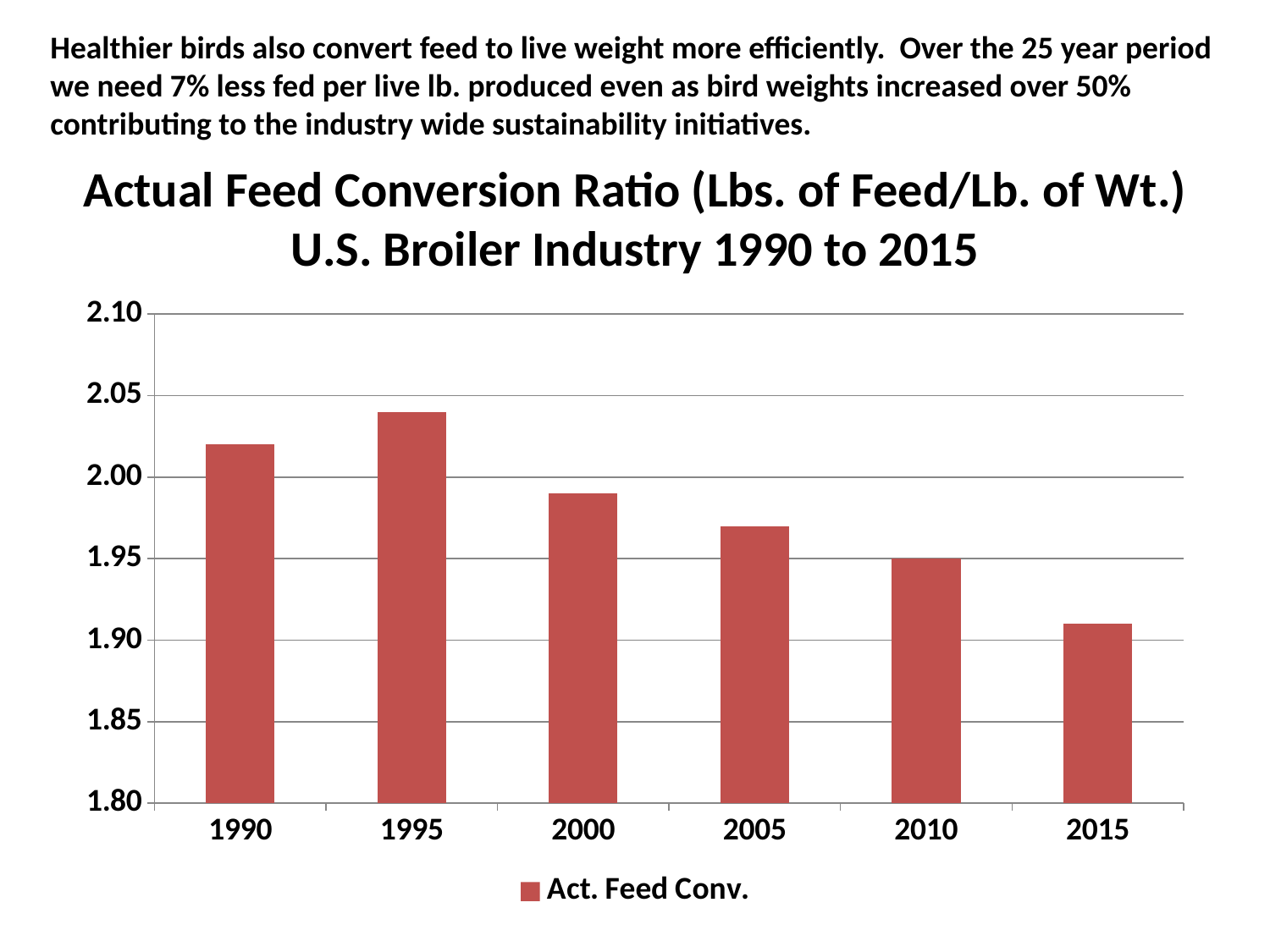
Which year has the lowest actual feed conversion ratio? 2015 Is the value for 1990 greater or less than 2.00? greater Is the value for 2015 greater or less than 1.95? less Is the value for 1995 greater or less than 2.05? less What is the name of the series shown in the legend? Act. Feed Conv. How many series does the legend list? 1 What type of chart is shown on the slide? bar chart How many years are plotted on the x axis of the chart? 6 Which is larger, the value for 1990 or the value for 2005? 1990 From 1995 to 2015, do the values rise or fall along the x axis? fall Which year has the highest actual feed conversion ratio? 1995